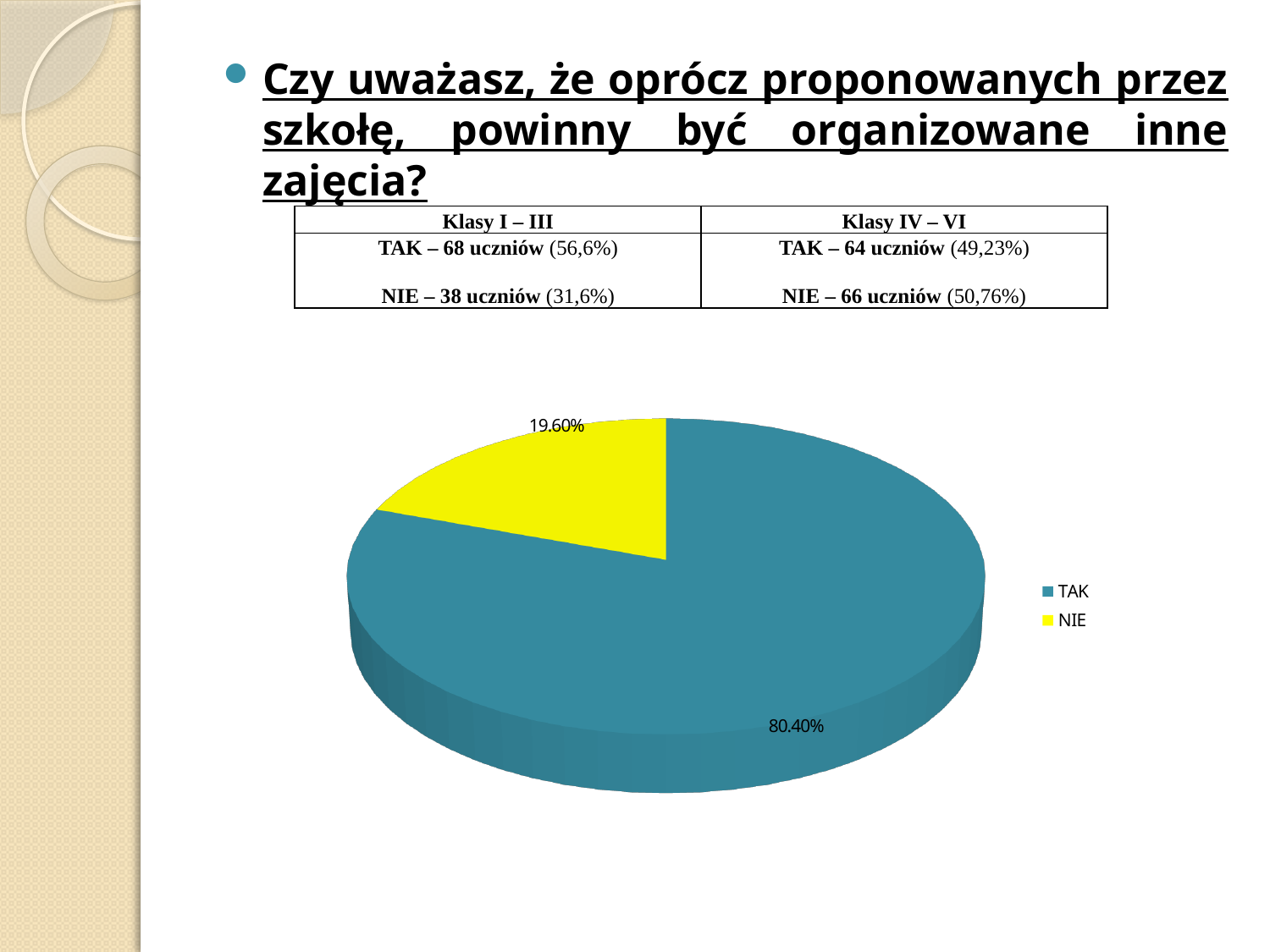
What colour is the TAK slice in the pie chart? teal (blue-green) How many entries does the legend of the pie chart list? 2 Which is larger in the pie chart, the TAK slice or the NIE slice? TAK What share of the pie does the TAK slice represent? 80.40% What colour is the NIE slice in the pie chart? yellow What is the difference in percentage points between the TAK and NIE slices? 60.80% Which slice of the pie chart is the largest? TAK What kind of chart is shown on the slide? pie chart Is the value for NIE in the pie chart greater or less than 50%? less How many slices does the pie chart have? 2 What share of the pie does the NIE slice represent? 19.60% Which slice of the pie chart is the smallest? NIE